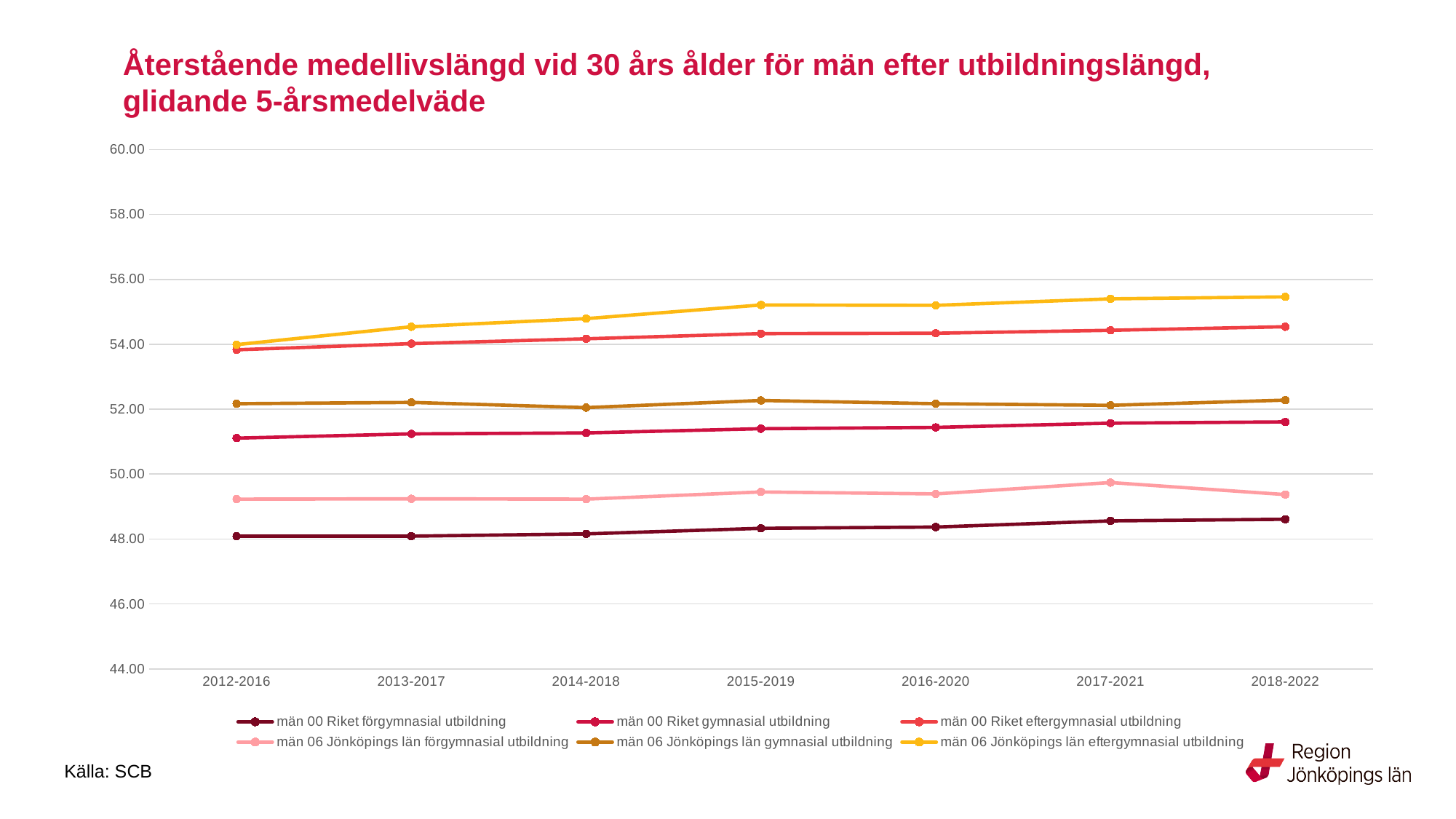
Is the value for män 00 Riket gymnasial utbildning in 2018-2022 greater or less than 52.00? less In 2012-2016, which is larger: män 06 Jönköpings län förgymnasial utbildning or män 00 Riket förgymnasial utbildning? män 06 Jönköpings län förgymnasial utbildning In 2018-2022, which is larger: män 00 Riket eftergymnasial utbildning or män 06 Jönköpings län eftergymnasial utbildning? män 06 Jönköpings län eftergymnasial utbildning Does the line for män 00 Riket förgymnasial utbildning rise or fall from 2012-2016 to 2018-2022? rise How many series does the legend list? 6 How many periods are shown on the x axis? 7 Which series has the highest value in 2018-2022? män 06 Jönköpings län eftergymnasial utbildning Is the value for män 00 Riket förgymnasial utbildning in 2012-2016 greater or less than 50.00? less Is the value for män 06 Jönköpings län eftergymnasial utbildning in 2018-2022 greater or less than 54.00? greater Which series has the lowest value in 2012-2016? män 00 Riket förgymnasial utbildning What source is cited for the chart data? SCB What kind of chart is shown on the slide? line chart